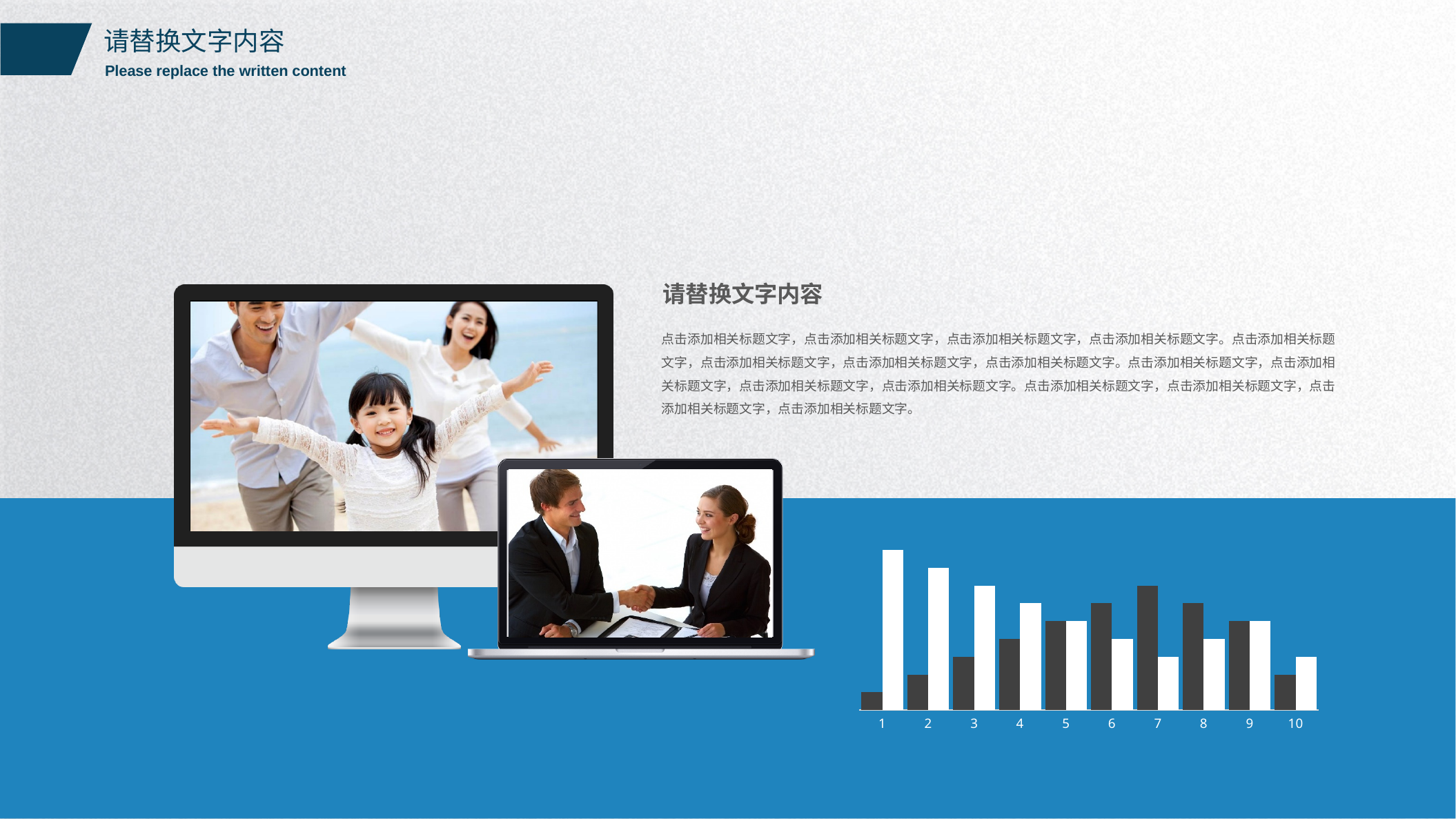
In category 1 of the bar chart, which bar is taller, the white bar or the dark bar? the white bar What two colours are the bars in the bar chart? white and dark grey What are the first and last category labels on the x axis of the bar chart? 1 and 10 How many categories are shown on the x axis of the bar chart? 10 In category 7 of the bar chart, which bar is taller, the white bar or the dark bar? the dark bar Which category has the tallest dark bar in the bar chart? 7 Which category has the shortest dark bar in the bar chart? 1 How many bars are plotted for each category in the bar chart? 2 What kind of chart is shown at the bottom right of the slide? bar chart Which category has the tallest white bar in the bar chart? 1 Do the white bars generally rise or fall from category 1 to category 7 in the bar chart? fall Do the dark bars rise or fall from category 1 to category 7 in the bar chart? rise